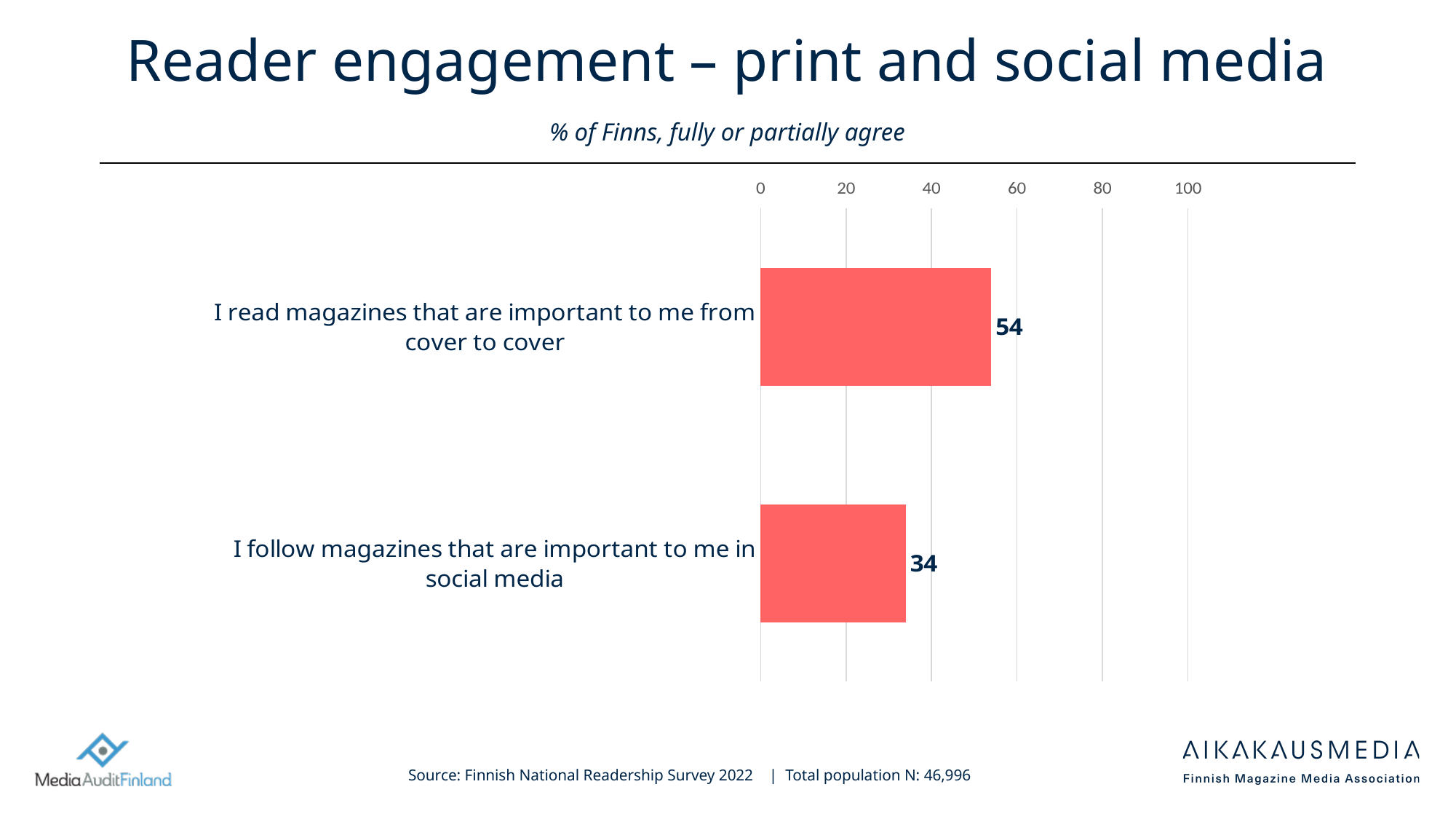
What is the maximum value shown on the chart's axis? 100 Which statement has the highest value? I read magazines that are important to me from cover to cover How many categories are shown in the chart? 2 What is the subtitle describing the chart's measure? % of Finns, fully or partially agree Is the value for "I read magazines that are important to me from cover to cover" greater or less than 60? less What is the difference between the value for reading magazines cover to cover and the value for following magazines in social media? 20 Which statement has the lowest value? I follow magazines that are important to me in social media What kind of chart is shown on the slide? bar chart What is the value for "I read magazines that are important to me from cover to cover"? 54 Is the value for "I follow magazines that are important to me in social media" greater or less than 40? less What is the value for "I follow magazines that are important to me in social media"? 34 Which is larger: the value for reading magazines cover to cover or the value for following magazines in social media? I read magazines that are important to me from cover to cover